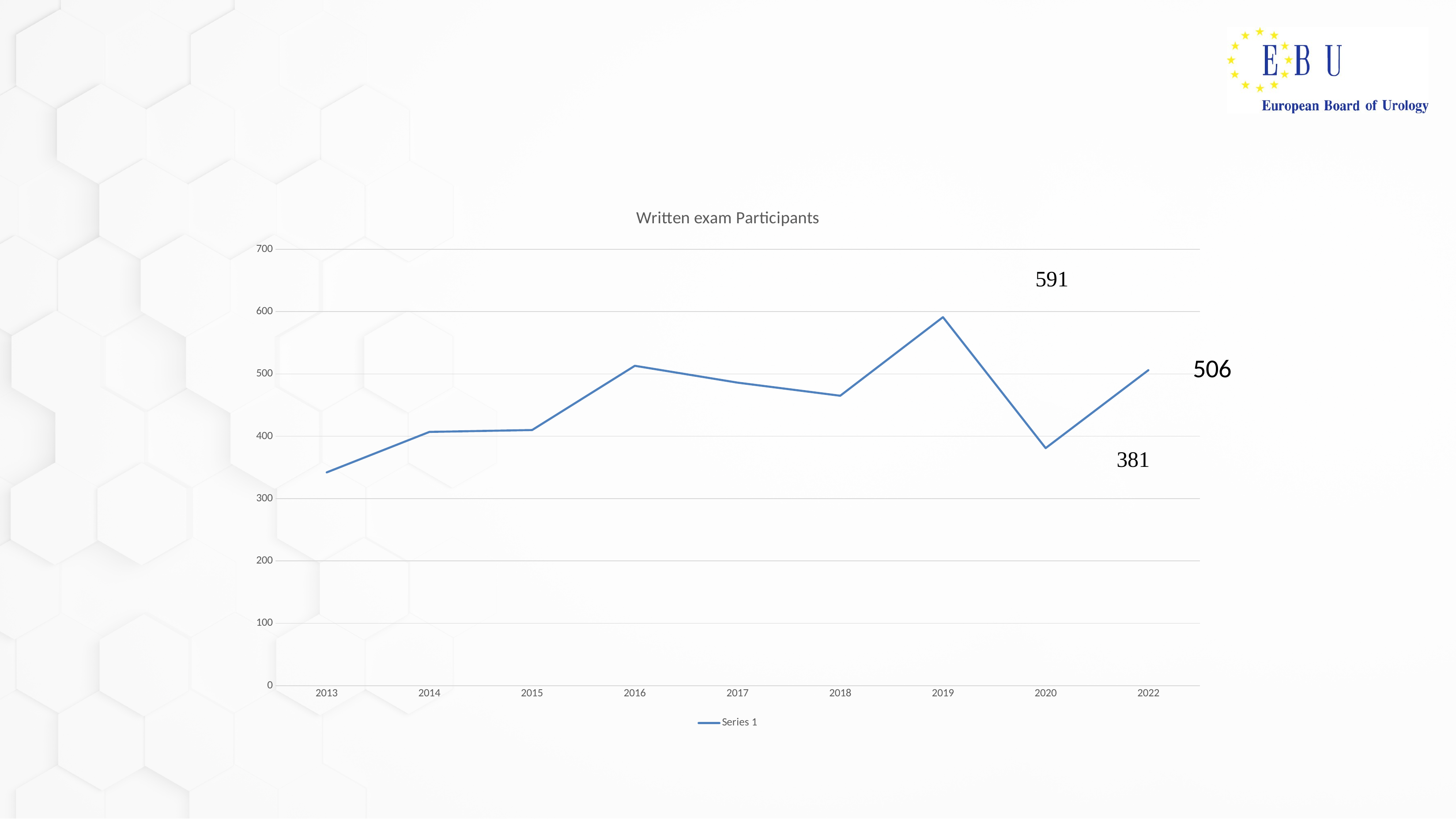
Do the values rise or fall from 2013 to 2016? rise What kind of chart is shown on the slide? line chart What is the value for 2022? 506 What is the value for 2020? 381 Which is larger, the value for 2019 or the value for 2022? 2019 How many years are plotted on the x axis? 9 What is the title of the chart? Written exam Participants What is the value for 2019? 591 Is the value for 2013 greater or less than 400? less Which year has the highest number of written exam participants? 2019 How many series does the legend list? 1 What is the difference between the values for 2019 and 2020? 210